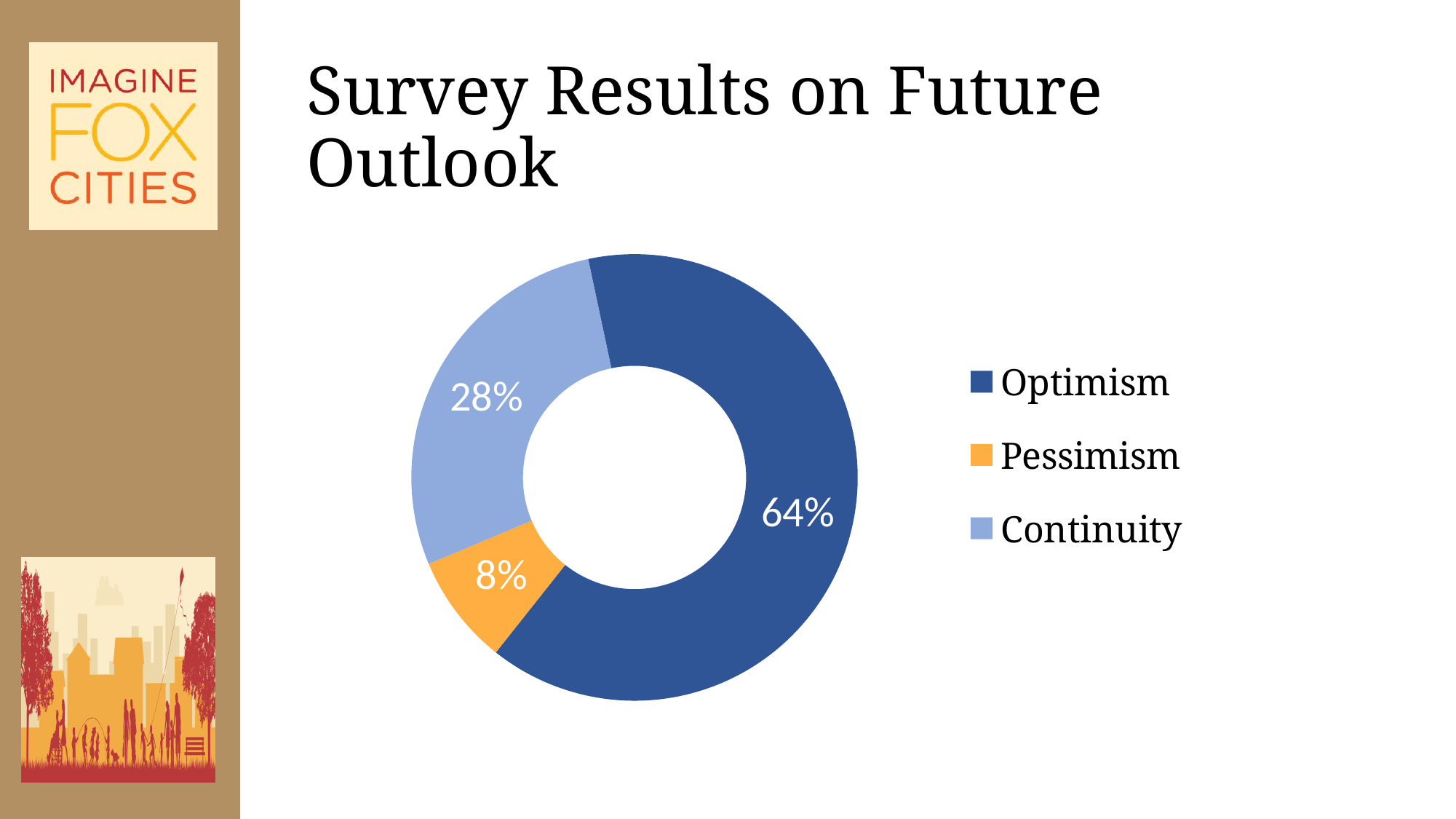
What kind of chart is shown on the slide? Doughnut chart Which is larger, the share for Continuity or the share for Pessimism? Continuity Which category has the smallest share of the pie chart? Pessimism What is the title of the chart on the slide? Survey Results on Future Outlook What percentage of the pie chart is Optimism? 64% What is the difference in percentage points between Optimism and Continuity? 36 What percentage of the pie chart is Pessimism? 8% Which category has the largest share of the pie chart? Optimism How many categories are shown in the pie chart? 3 Which colour represents Pessimism in the pie chart? Orange What percentage of the pie chart is Continuity? 28% What is the difference in percentage points between Continuity and Pessimism? 20